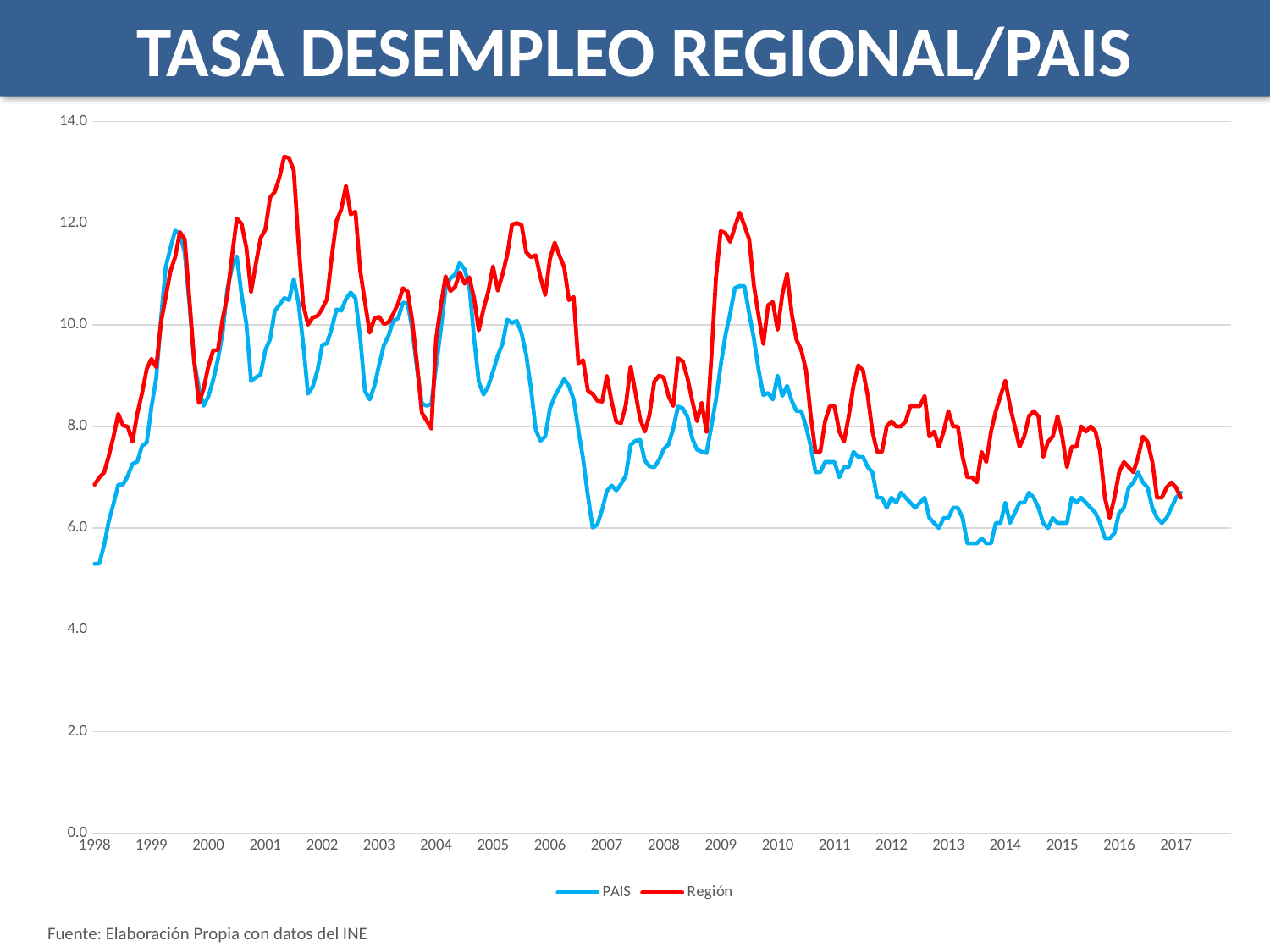
Do the values of the Región series generally rise or fall from 2001 to 2017? fall Is the value of the Región series at the end of 2017 greater or less than 8.0? less What are the two series named in the legend? PAIS and Región Is the peak value of the Región series around 2001 greater or less than 12.0? greater Is the peak value of the PAIS series in 2009 greater or less than 10.0? greater How many series does the legend list? 2 Which series is generally higher across the chart, PAIS or Región? Región Around 2001, which series has the higher value, PAIS or Región? Región What kind of chart is shown on the slide? line chart What is the title of the chart? TASA DESEMPLEO REGIONAL/PAIS